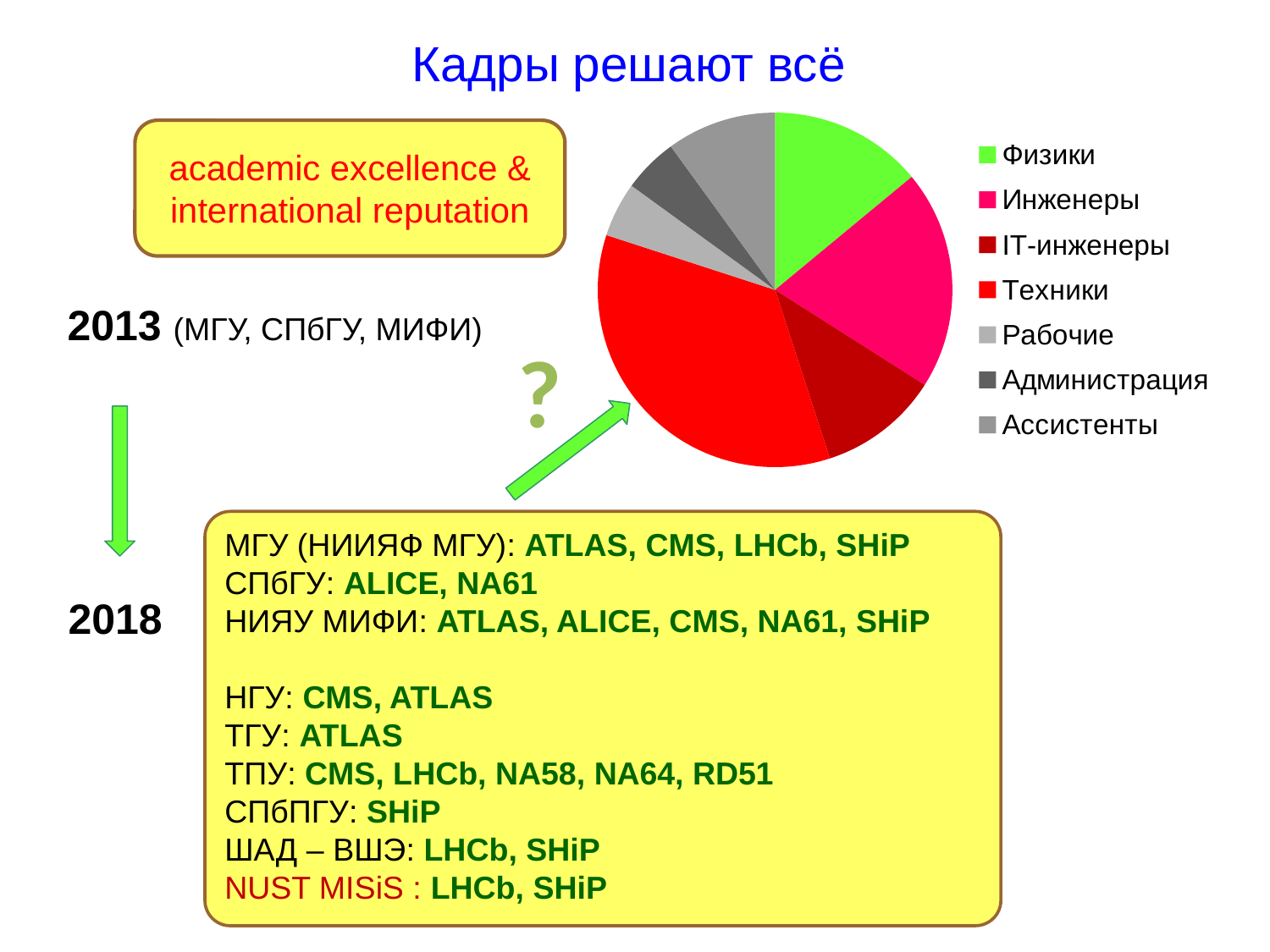
Which slice is larger in the pie chart, Техники or Ассистенты? Техники Which category is shown in green in the pie chart legend? Физики Which slice is larger in the pie chart, Техники or Физики? Техники Which category has the largest slice in the pie chart? Техники How many categories (slices) does the pie chart have? 7 Which slice is larger in the pie chart, Физики or Администрация? Физики What colour is the Техники slice in the pie chart? red What kind of chart is shown on the slide? pie chart